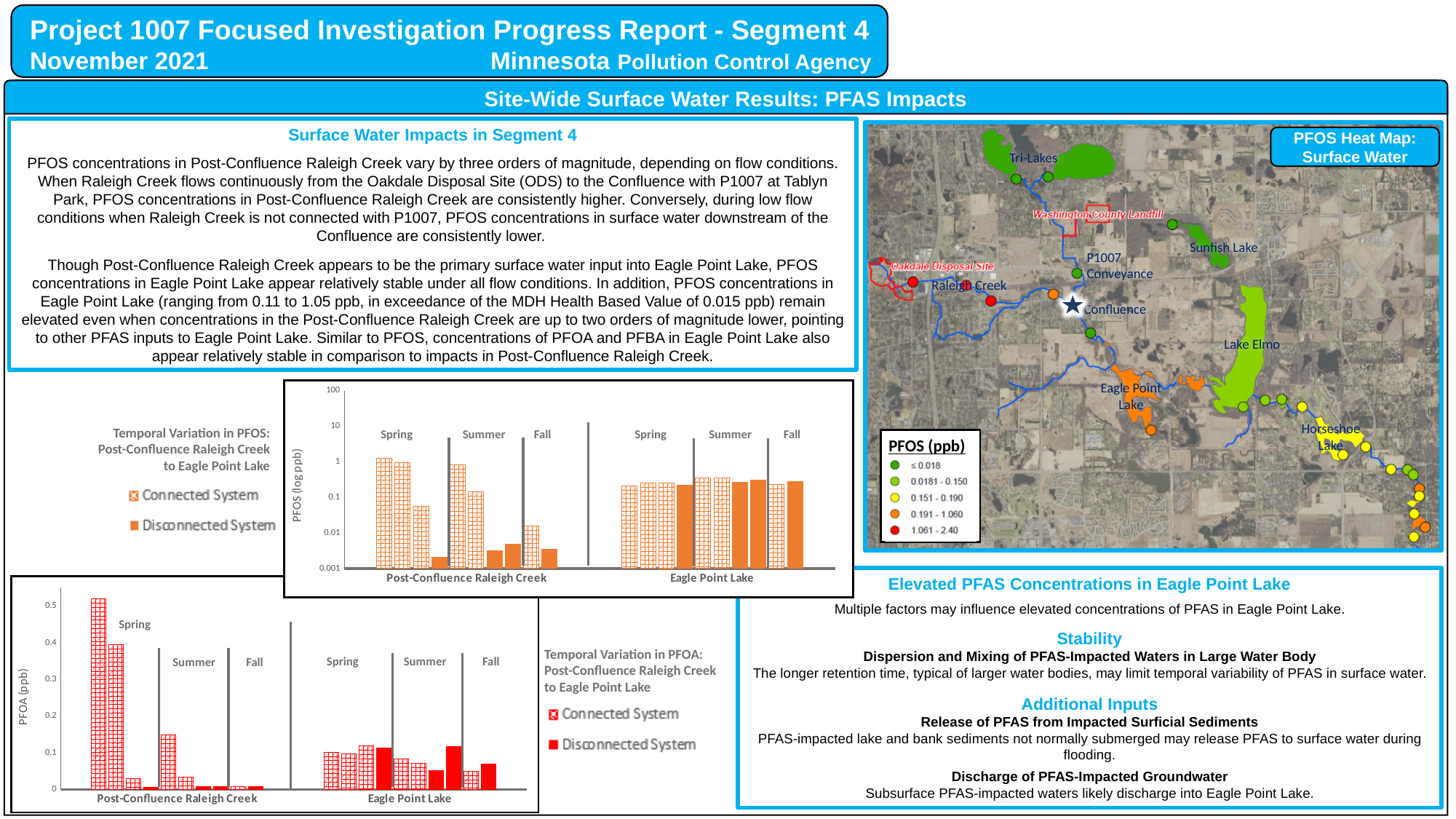
In the PFOA chart, is the tallest Spring Connected System bar for Post-Confluence Raleigh Creek greater or less than 0.5? greater How many series does the legend of the PFOS chart list? 2 What are the two series named in the legend of the PFOA chart? Connected System and Disconnected System What kind of chart is the PFOA chart (bottom left, 'Temporal Variation in PFOA')? bar chart In the PFOS chart, are the Fall Disconnected System bars for Post-Confluence Raleigh Creek greater or less than 0.01? less In the PFOS chart, which season has the tallest bars for Post-Confluence Raleigh Creek? Spring How many seasons are shown for each location in the PFOA chart? 3 What kind of chart is the PFOS chart (top, 'Temporal Variation in PFOS')? bar chart In the PFOS chart, are the Eagle Point Lake bars greater or less than 0.1? greater In the PFOA chart, which location has the tallest bar overall, Post-Confluence Raleigh Creek or Eagle Point Lake? Post-Confluence Raleigh Creek What is the y-axis label of the PFOS chart? PFOS (log ppb)